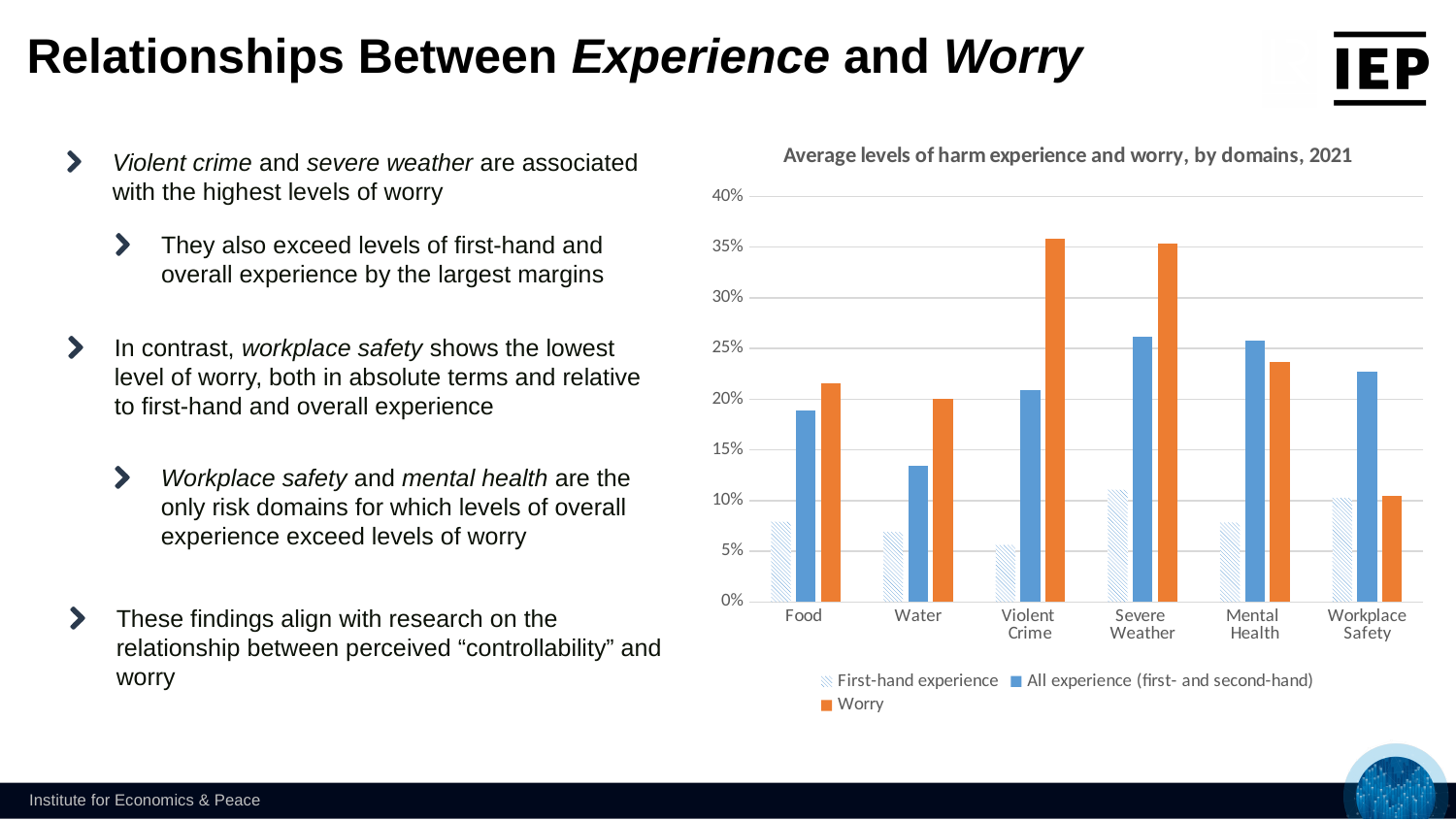
Which domain has the lowest Worry value? Workplace Safety Is the All experience (first- and second-hand) value for Severe Weather greater or less than 20%? greater Which domain has the lowest value for All experience (first- and second-hand)? Water For Workplace Safety, which is larger: the Worry value or the All experience (first- and second-hand) value? All experience (first- and second-hand) What is the title of the chart? Average levels of harm experience and worry, by domains, 2021 Which domain has a higher Worry value: Food or Violent Crime? Violent Crime How many series does the chart legend list? 3 What type of chart is shown on the slide? bar chart Is the Worry value for Workplace Safety greater or less than 15%? less Is the Worry value for Violent Crime greater or less than 30%? greater How many domains (categories) are shown on the x axis of the chart? 6